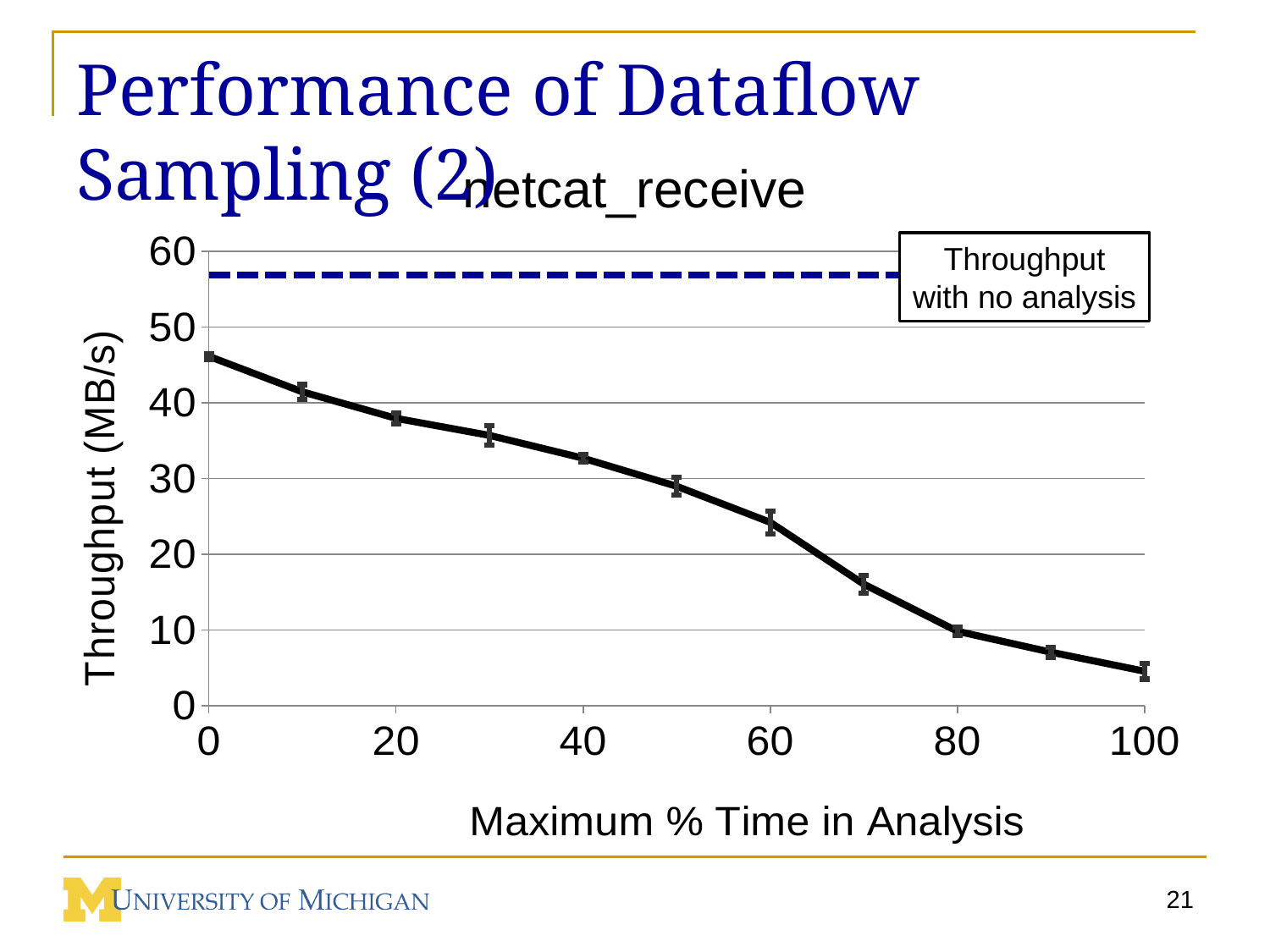
At which Maximum % Time in Analysis value is throughput lowest? 100 Is the throughput at 60% Maximum Time in Analysis greater or less than 20? greater Which has higher throughput: 20% or 80% Maximum Time in Analysis? 20% Is the throughput at 0% Maximum Time in Analysis greater or less than 40? greater Is the throughput at 100% Maximum Time in Analysis greater or less than 10? less What is the label of the y axis? Throughput (MB/s) What kind of chart is shown on the slide? line chart What is the title of the chart? netcat_receive Does throughput rise or fall as Maximum % Time in Analysis increases? fall At which Maximum % Time in Analysis value is throughput highest? 0 How many data points are plotted on the line? 11